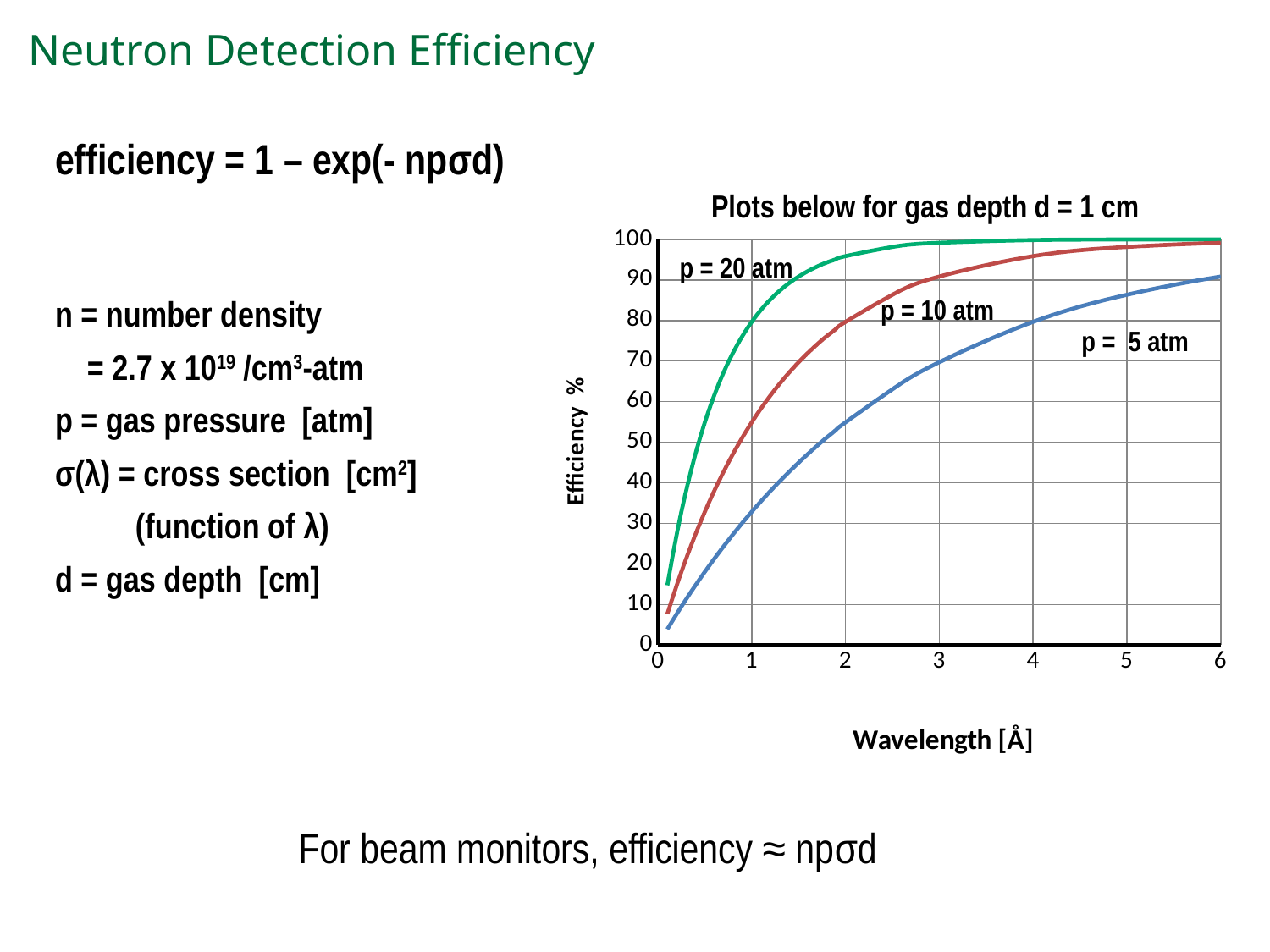
At a wavelength of 2 Å, which curve is higher: p = 10 atm or p = 5 atm? p = 10 atm What gas depth d do the plotted curves correspond to, according to the chart title? d = 1 cm What kind of chart is shown on the slide? line chart How many curves (pressure series) are plotted on the chart? 3 Is the efficiency of the p = 5 atm curve at 1 Å greater or less than 40? less Is the efficiency of the p = 20 atm curve at 1 Å greater or less than 70? greater Does the efficiency rise or fall as wavelength increases along the x axis? rise Is the efficiency of the p = 10 atm curve at 2 Å greater or less than 70? greater What is the label of the x axis of the chart? Wavelength [Å] Which curve has the lowest efficiency at a wavelength of 3 Å? p = 5 atm Which curve has the highest efficiency at a wavelength of 1 Å? p = 20 atm